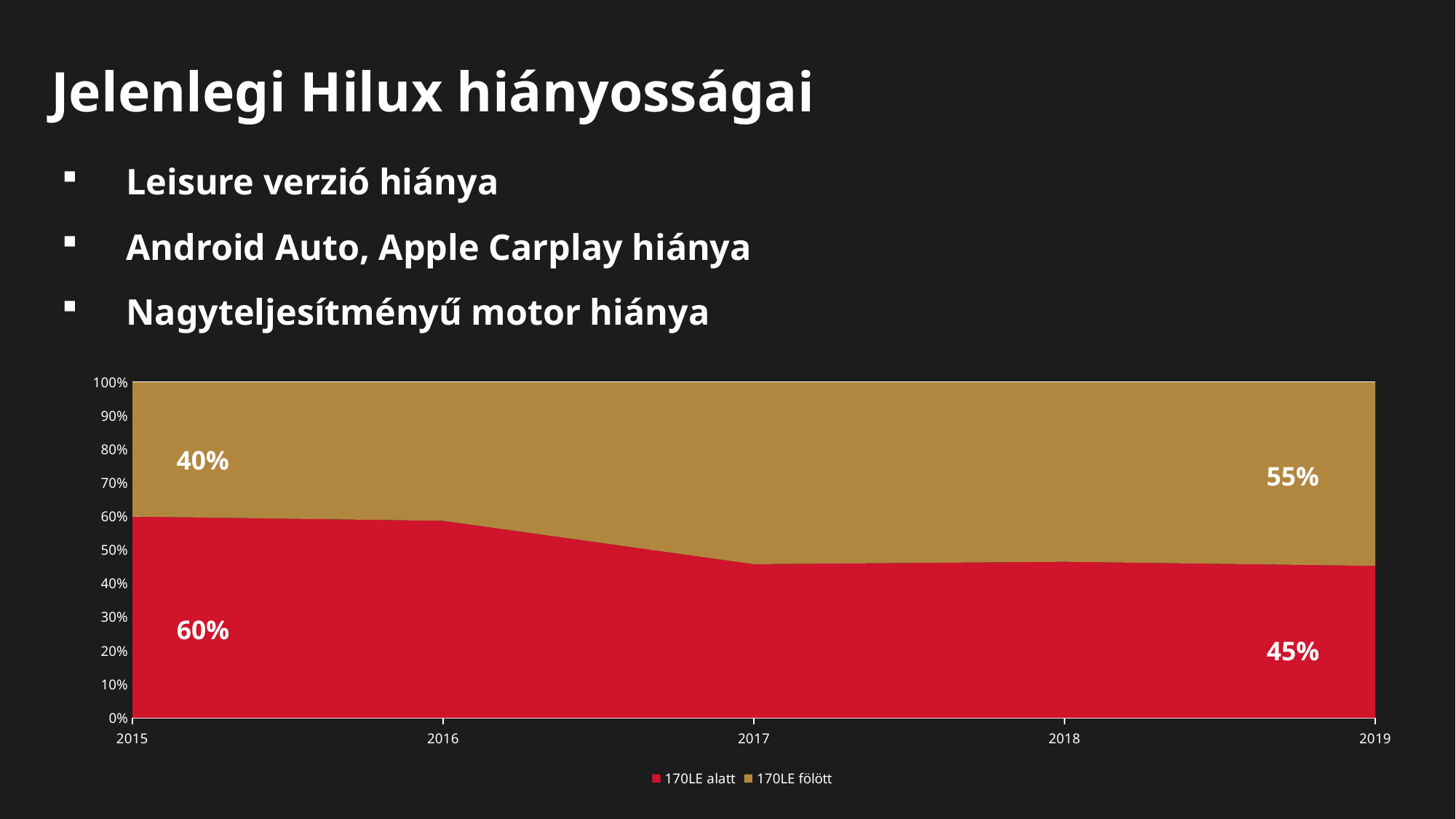
In 2015, which series has the larger share: 170LE alatt or 170LE fölött? 170LE alatt What kind of chart is shown on the slide? Stacked area chart Does the share of 170LE fölött rise or fall from 2015 to 2019? rise In 2019, which series has the larger share: 170LE alatt or 170LE fölött? 170LE fölött What is the value for the 170LE fölött series in 2019? 55% What is the value for the 170LE alatt series in 2019? 45% What is the value for the 170LE fölött series in 2015? 40% How many series does the chart legend list? 2 By how many percentage points did the 170LE alatt share fall from 2015 to 2019? 15 Is the value for 170LE alatt in 2016 greater or less than 50%? greater What is the value for the 170LE alatt series in 2015? 60% How many years are shown on the x axis of the chart? 5